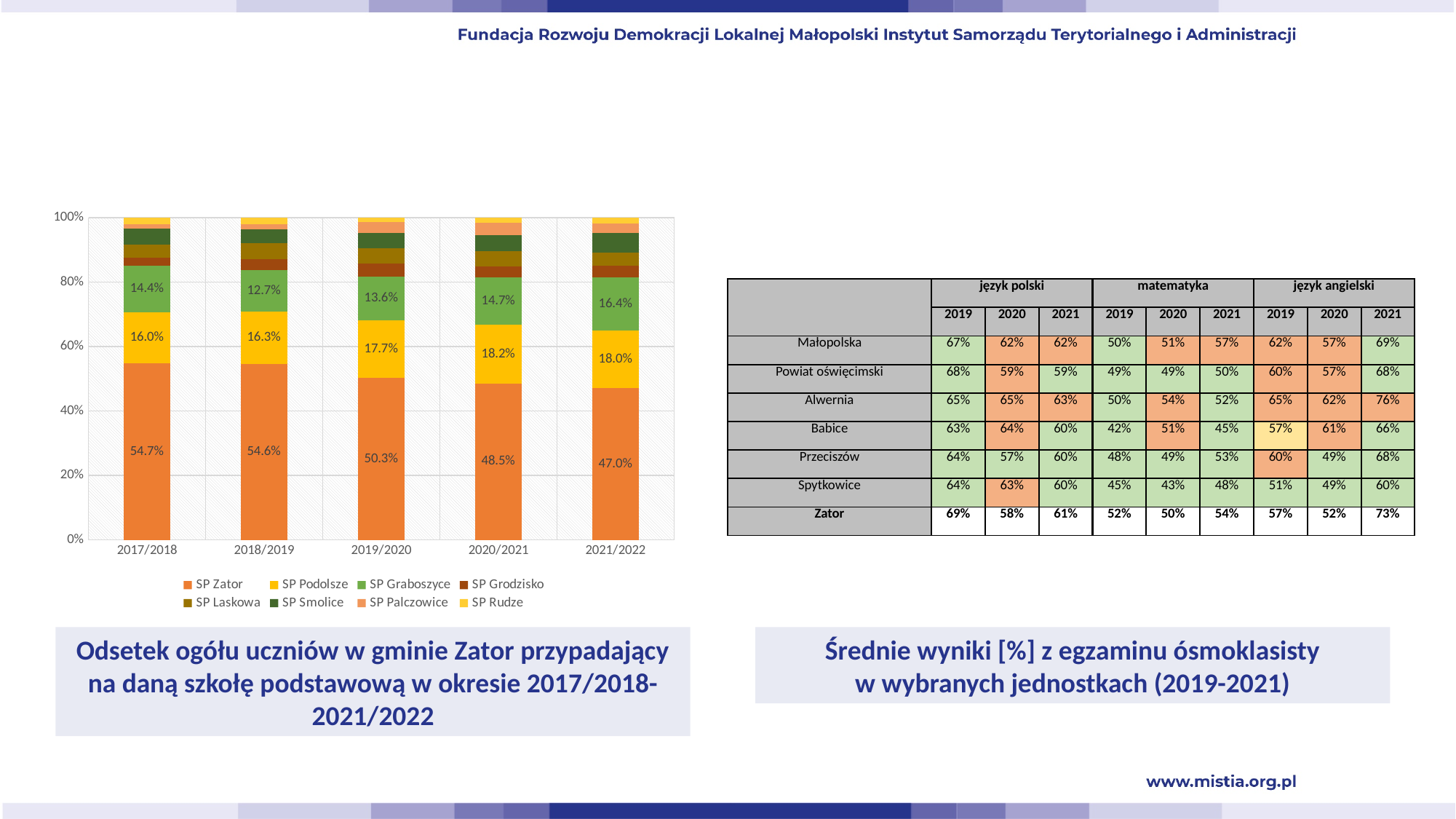
In the stacked bar chart, what share of pupils did SP Podolsze have in 2020/2021? 18.2% What type of chart is shown on the left of the slide? Stacked bar chart In the stacked bar chart, what share of pupils did SP Zator have in 2017/2018? 54.7% How many school years are shown on the x axis of the stacked bar chart? 5 In the stacked bar chart, what share of pupils did SP Graboszyce have in 2021/2022? 16.4% In the stacked bar chart, by how many percentage points did the SP Zator share fall from 2017/2018 to 2021/2022? 7.7 percentage points In the stacked bar chart, in which school year was the SP Zator share the lowest? 2021/2022 In the stacked bar chart, in which school year was the SP Graboszyce share the lowest? 2018/2019 In the stacked bar chart, which had the larger share in 2019/2020: SP Podolsze or SP Graboszyce? SP Podolsze In the stacked bar chart, in which school year was the SP Podolsze share the highest? 2020/2021 How many schools are listed in the legend of the stacked bar chart? 8 In the stacked bar chart, does the SP Zator share rise or fall from 2017/2018 to 2021/2022? It falls